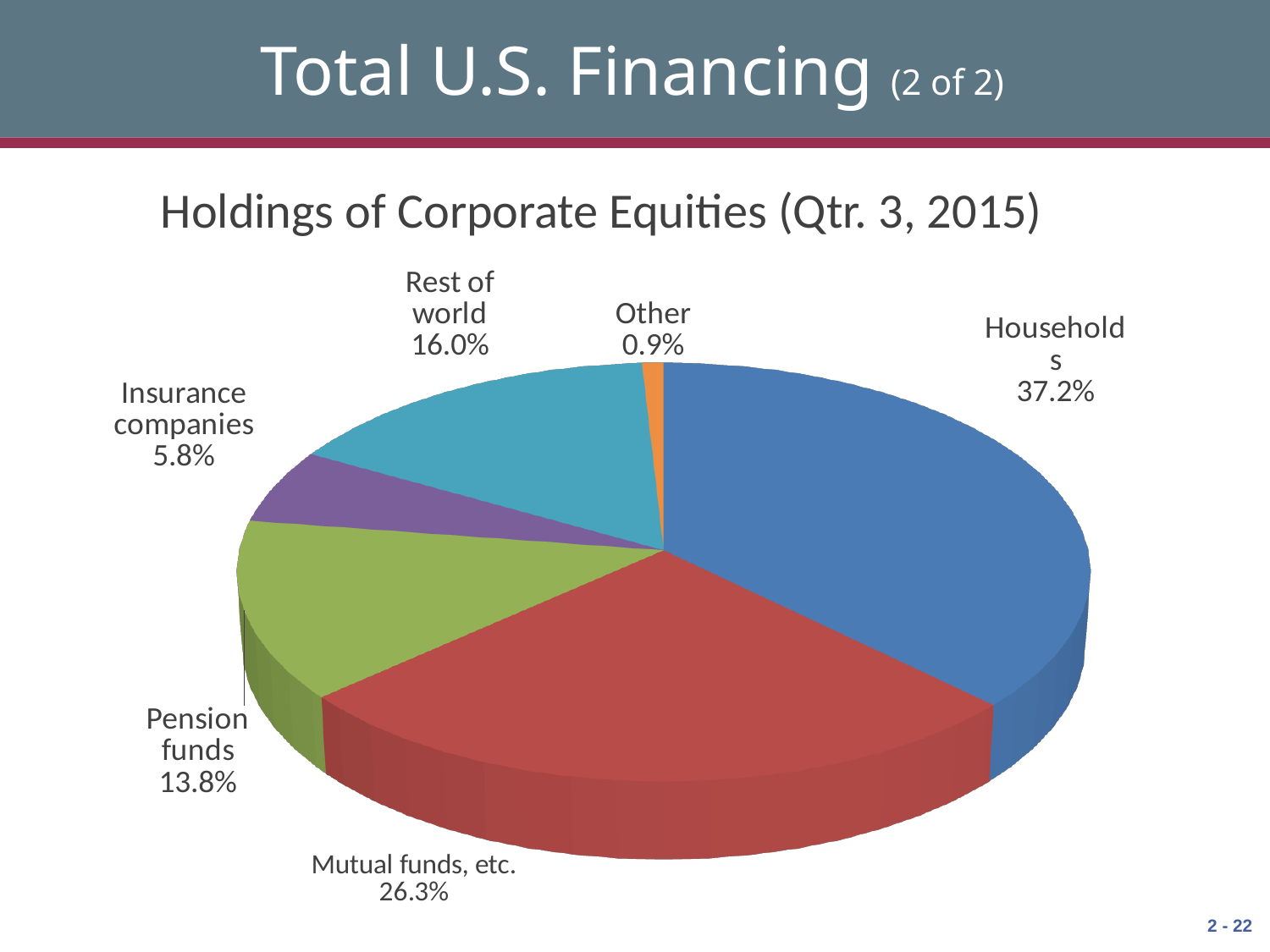
What share of corporate equity holdings is held by Pension funds? 13.8% Which category holds the smallest share of corporate equities? Other What is the difference in percentage points between the Households share and the Mutual funds, etc. share? 10.9 What kind of chart is shown on the slide? Pie chart What share of corporate equity holdings is held by Rest of world? 16.0% Which category holds the largest share of corporate equities? Households What share of corporate equity holdings is held by Households? 37.2% Which holds a larger share of corporate equities, Rest of world or Pension funds? Rest of world How many categories are shown in the pie chart? 6 What share of corporate equity holdings is held by Mutual funds, etc.? 26.3% What share of corporate equity holdings is held by Insurance companies? 5.8% What is the title of the chart? Holdings of Corporate Equities (Qtr. 3, 2015)